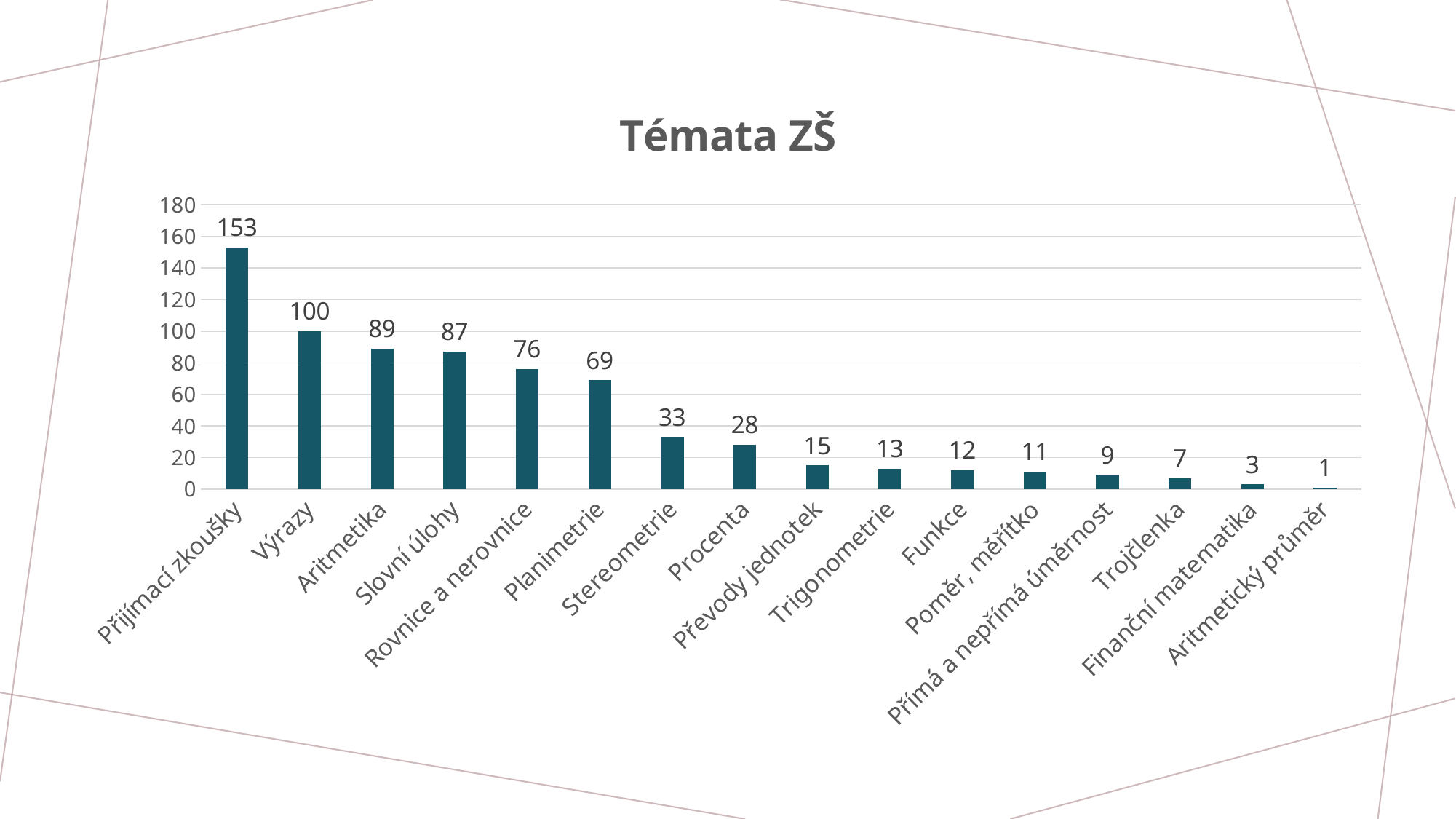
What is the difference between the values for Výrazy and Aritmetika? 11 Which category has the highest value? Přijímací zkoušky What is the difference between the values for Stereometrie and Procenta? 5 What is the value for Trigonometrie? 13 What is the value for Planimetrie? 69 What kind of chart is shown on the slide? bar chart What is the title of the chart? Témata ZŠ How many categories are shown on the chart? 16 Is the value for Přijímací zkoušky greater or less than 140? greater Which category has the lowest value? Aritmetický průměr What is the value for Přijímací zkoušky? 153 Which is larger, the value for Slovní úlohy or the value for Rovnice a nerovnice? Slovní úlohy